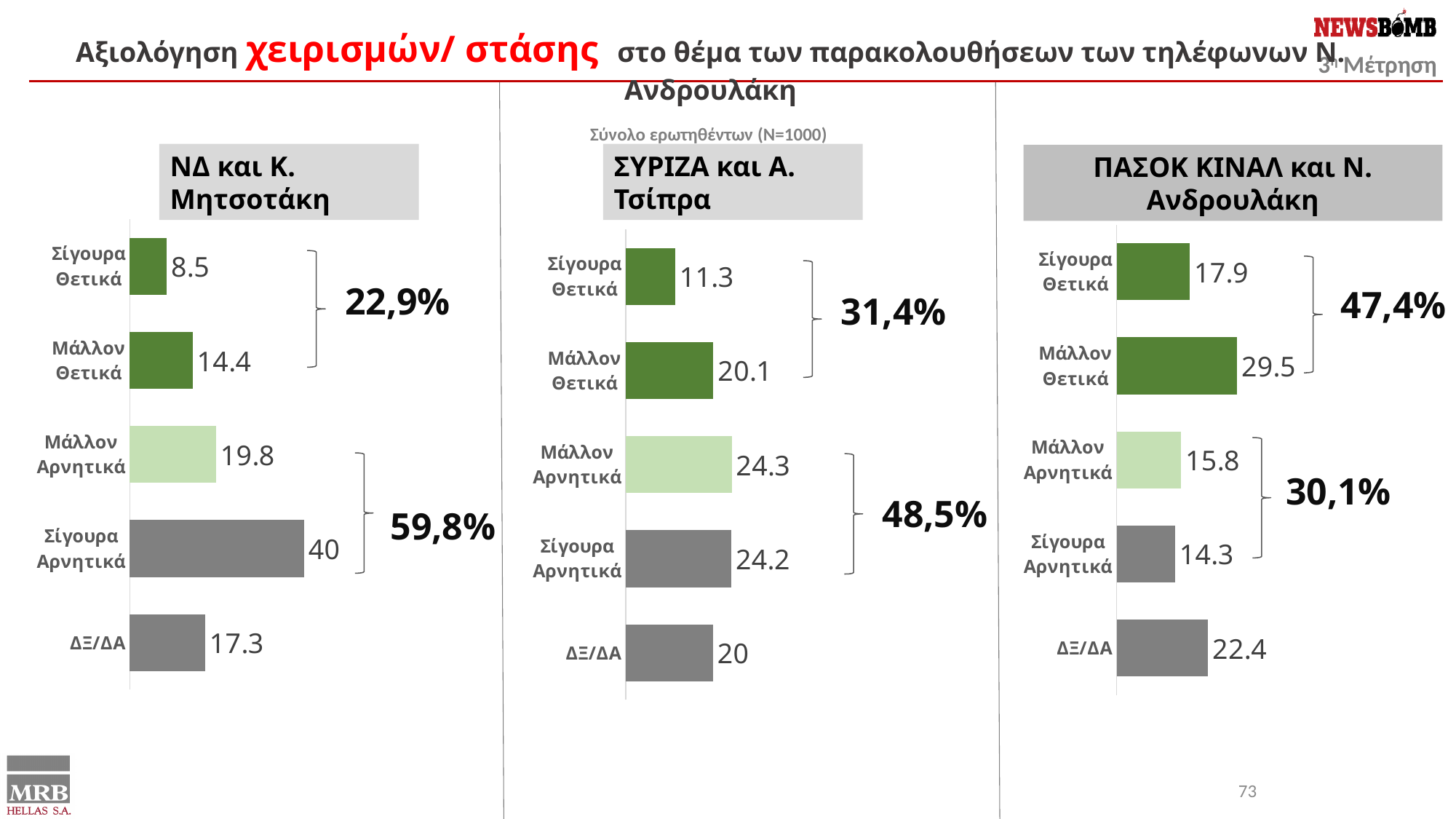
In the ΝΔ και Κ. Μητσοτάκη chart, what is the difference between Σίγουρα Αρνητικά and Μάλλον Αρνητικά? 20.2 What kind of chart is the ΠΑΣΟΚ ΚΙΝΑΛ και Ν. Ανδρουλάκη chart? Bar chart How many categories does the ΝΔ και Κ. Μητσοτάκη chart show? 5 What combined percentage is shown next to the bracket grouping the two negative categories in the ΣΥΡΙΖΑ και Α. Τσίπρα chart? 48,5% In the ΣΥΡΙΖΑ και Α. Τσίπρα chart, which category has the lowest value? Σίγουρα Θετικά In the ΣΥΡΙΖΑ και Α. Τσίπρα chart, which is larger: Μάλλον Θετικά or Σίγουρα Θετικά? Μάλλον Θετικά In the ΝΔ και Κ. Μητσοτάκη chart, which category has the lowest value? Σίγουρα Θετικά In the ΠΑΣΟΚ ΚΙΝΑΛ και Ν. Ανδρουλάκη chart, what is the difference between Μάλλον Θετικά and Σίγουρα Θετικά? 11.6 In the ΣΥΡΙΖΑ και Α. Τσίπρα chart, what is the value for Μάλλον Θετικά? 20.1 In the ΠΑΣΟΚ ΚΙΝΑΛ και Ν. Ανδρουλάκη chart, what is the value for ΔΞ/ΔΑ? 22.4 In the ΝΔ και Κ. Μητσοτάκη chart, what is the value for Σίγουρα Αρνητικά? 40 In the ΠΑΣΟΚ ΚΙΝΑΛ και Ν. Ανδρουλάκη chart, which category has the highest value? Μάλλον Θετικά